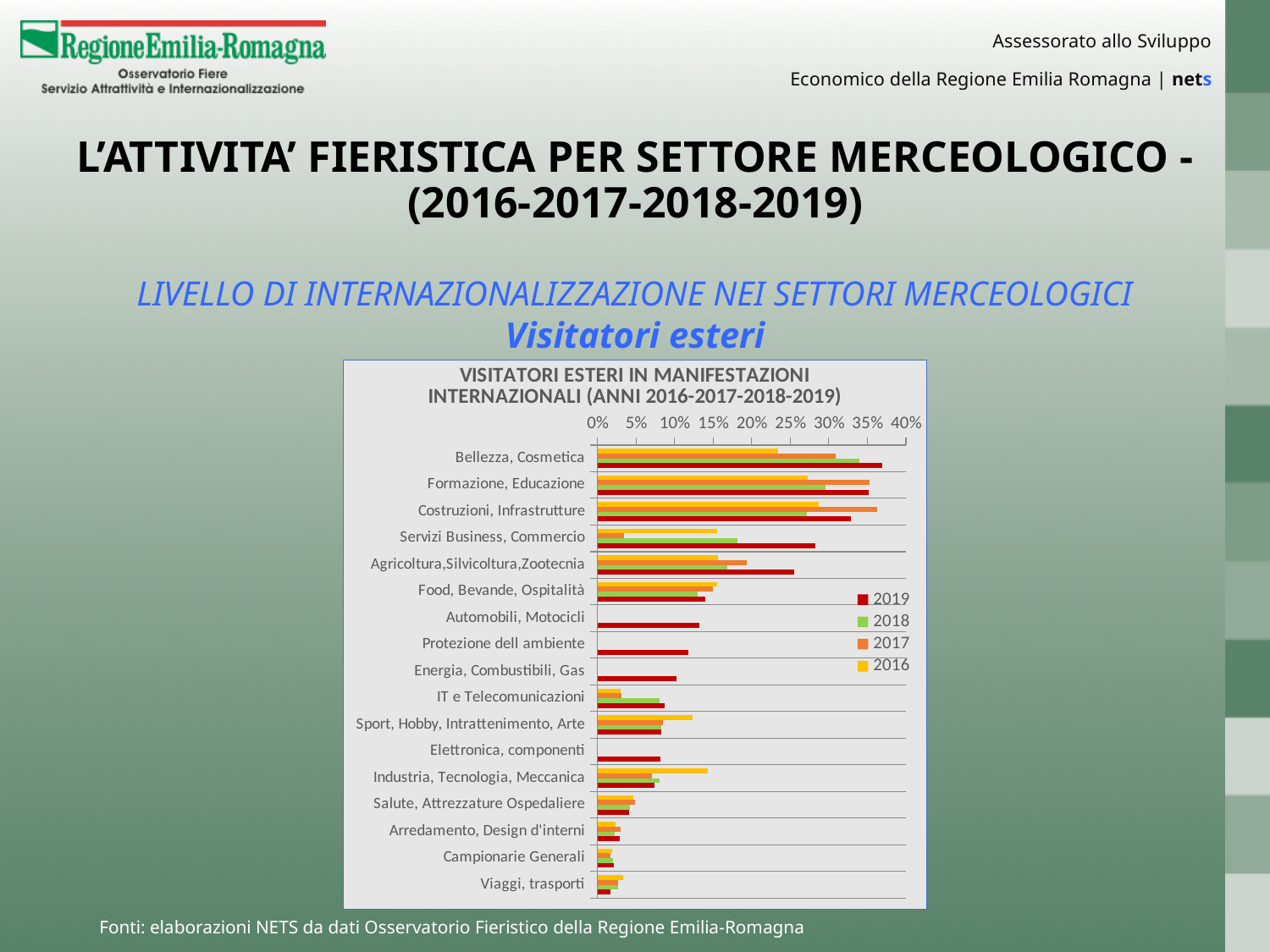
How many series does the legend of the chart list? 4 Is the 2019 value for Servizi Business, Commercio greater or less than 20%? greater How many sectors (categories) are plotted in the chart? 17 Is the 2019 value for Viaggi, trasporti greater or less than 5%? less What kind of chart is shown on the slide? Bar chart Is the 2017 value for Costruzioni, Infrastrutture greater or less than 30%? greater For Industria, Tecnologia, Meccanica, which is larger: the 2016 value or the 2019 value? 2016 Which years are listed in the chart legend? 2019, 2018, 2017, 2016 What is the title of the chart? VISITATORI ESTERI IN MANIFESTAZIONI INTERNAZIONALI (ANNI 2016-2017-2018-2019) For Servizi Business, Commercio, which is larger: the 2019 value or the 2016 value? 2019